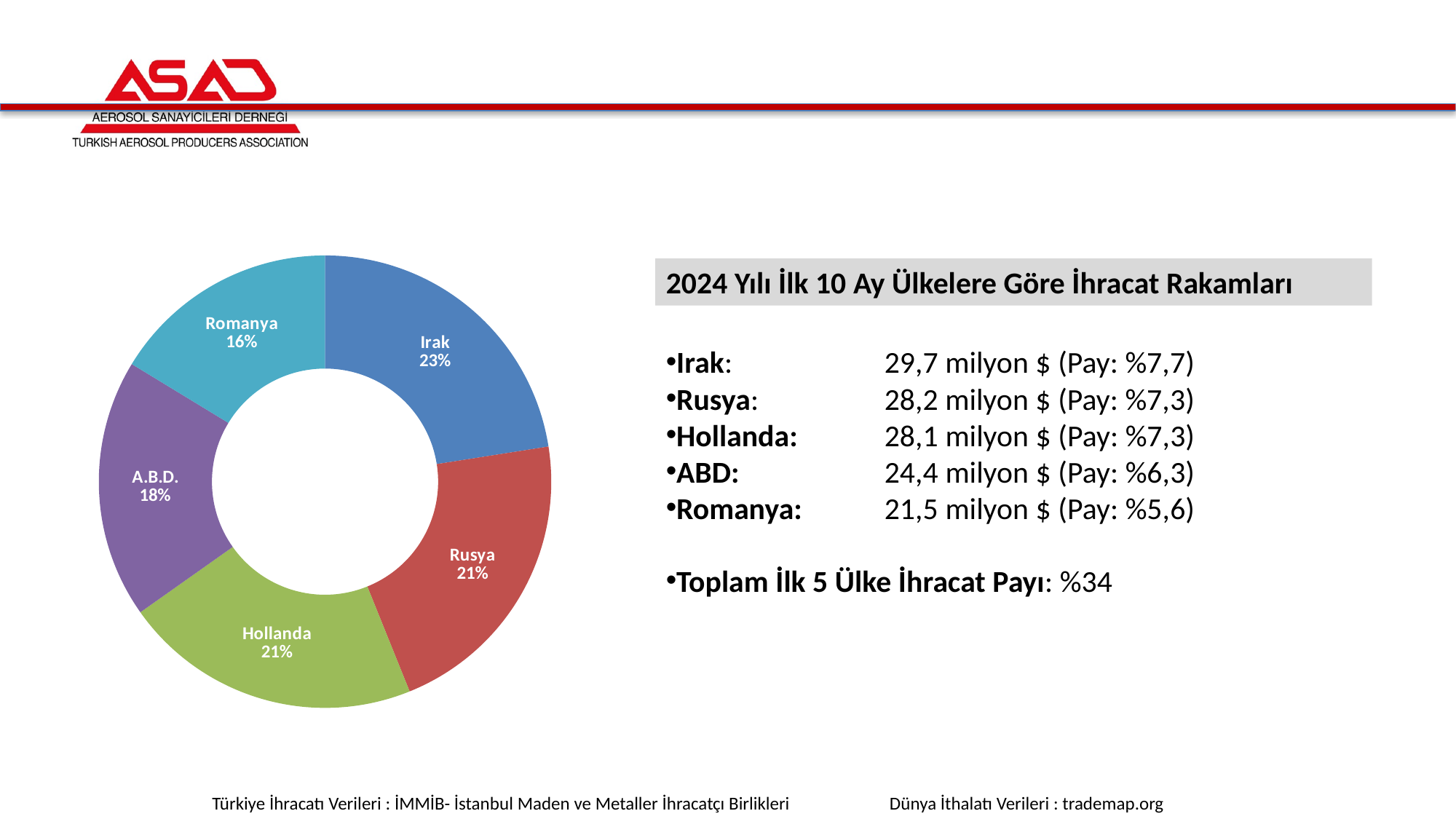
Which slice is larger in the donut chart, Irak or A.B.D.? Irak What percentage does the Irak slice show in the donut chart? 23% What percentage does the Hollanda slice show in the donut chart? 21% What is the difference in percentage points between the Irak slice and the Romanya slice? 7 Which country has the smallest slice in the donut chart? Romanya What share of the donut chart does Rusya account for? 21% What colour is the Hollanda slice in the donut chart? Green What percentage does the A.B.D. slice show in the donut chart? 18% What type of chart is shown on the slide? Pie (donut) chart How many countries are shown as slices in the donut chart? 5 What percentage does the Romanya slice show in the donut chart? 16% Which country has the largest slice in the donut chart? Irak